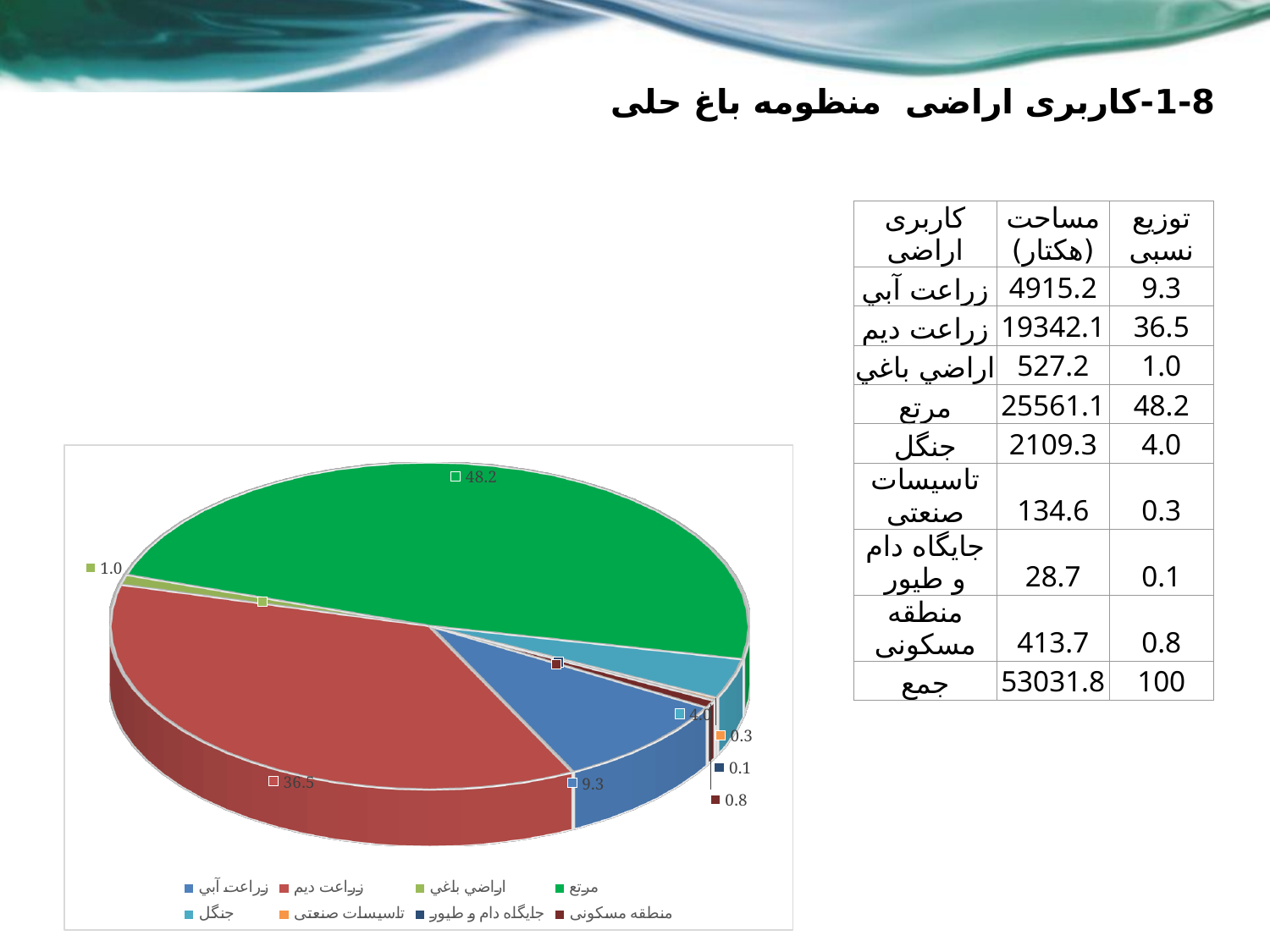
What is the value shown for اراضي باغي in the pie chart? 1.0 What is the value shown for زراعت آبي in the pie chart? 9.3 What is the value shown for زراعت ديم in the pie chart? 36.5 Which category has the largest slice in the pie chart? مرتع What is the difference between the values for مرتع and زراعت ديم in the pie chart? 11.7 Which is larger in the pie chart, the value for زراعت آبي or the value for جنگل? زراعت آبي How many slices does the pie chart have? 8 How many entries does the pie chart's legend list? 8 What colour is the slice for مرتع in the pie chart? green Which category has the smallest slice in the pie chart? جايگاه دام و طيور What is the value shown for مرتع in the pie chart? 48.2 What type of chart is shown on the slide? pie chart